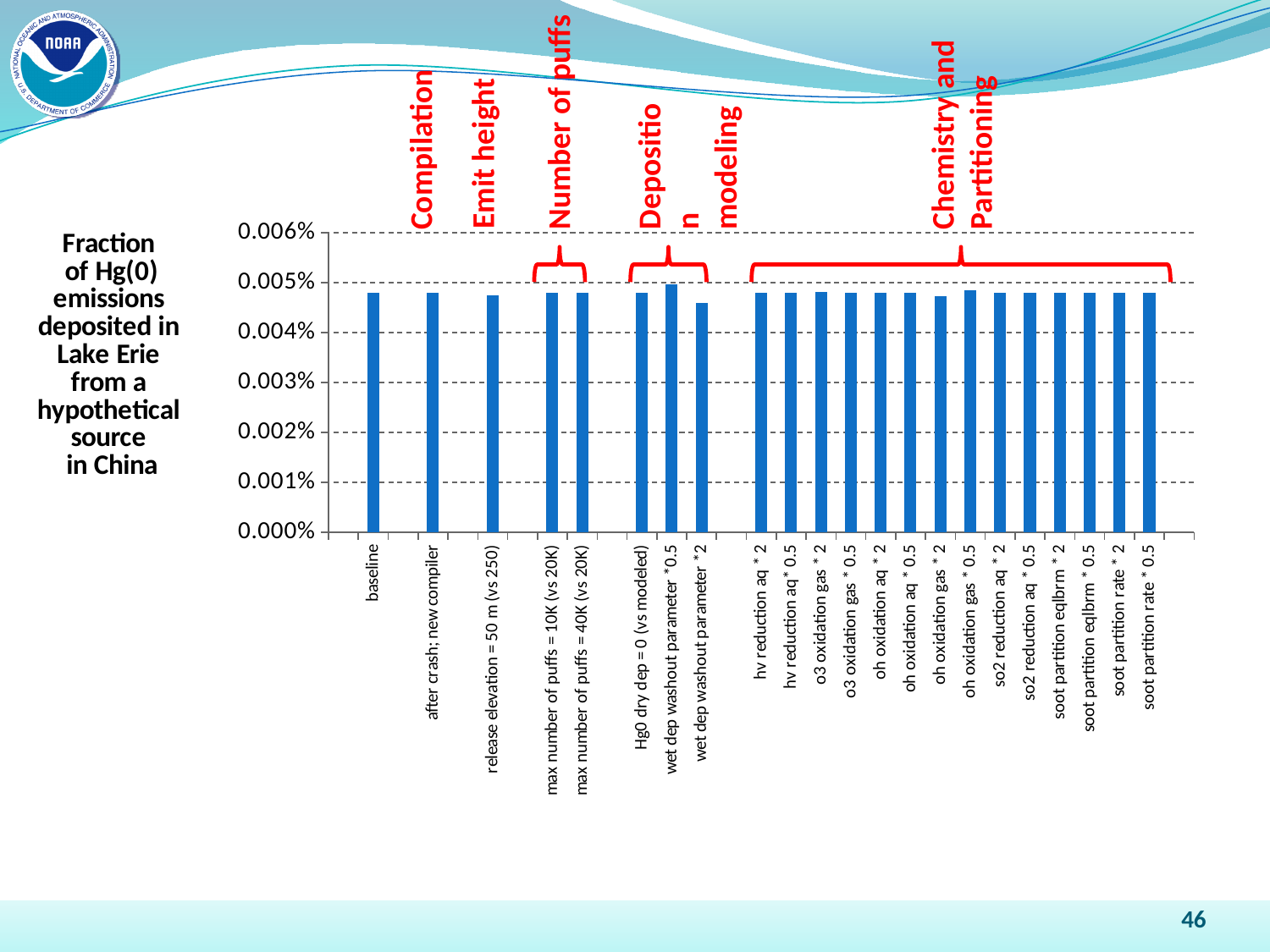
Is the value for baseline greater or less than 0.005%? less What is the highest value shown on the y-axis of the chart? 0.006% Which is larger, the value for baseline or the value for wet dep washout parameter *2? baseline Is the value for baseline greater or less than 0.004%? greater Is the value for wet dep washout parameter *2 greater or less than 0.005%? less What kind of chart is shown on the slide? bar chart Which category has the highest bar on the chart? wet dep washout parameter *0.5 How many categories (bars) are plotted on the chart? 22 What quantity does the chart's y-axis represent, according to the text to the left of the chart? Fraction of Hg(0) emissions deposited in Lake Erie from a hypothetical source in China Which is larger, the value for wet dep washout parameter *0.5 or the value for wet dep washout parameter *2? wet dep washout parameter *0.5 Which category has the lowest bar on the chart? wet dep washout parameter *2